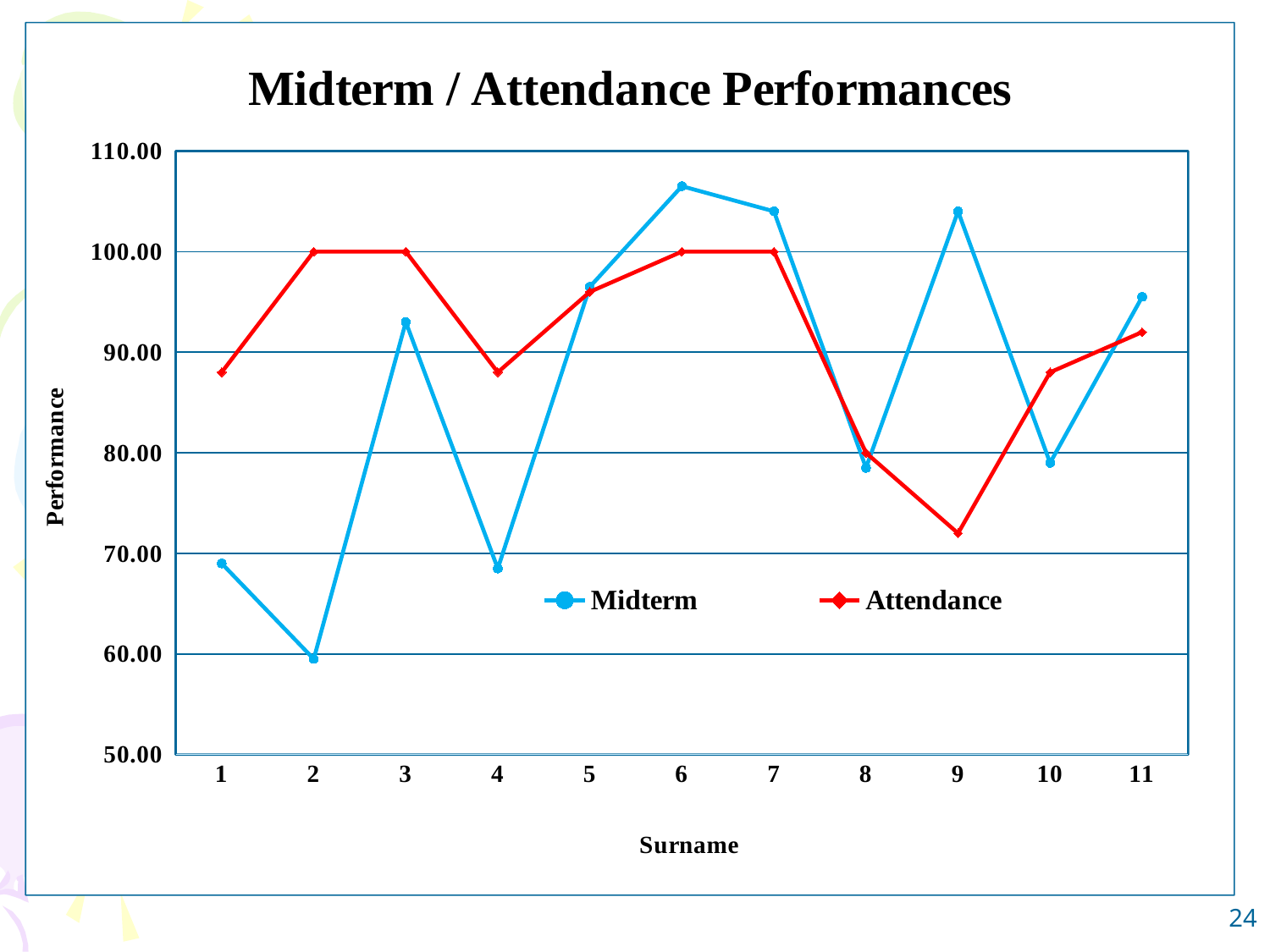
Is the Midterm value for surname 9 greater or less than 100.00? greater How many series does the legend list? 2 What is the Attendance value for surname 2? 100.00 At which surname number is the Midterm value highest? 6 At which surname number is the Midterm value lowest? 2 At which surname number is the Attendance value lowest? 9 For surname 3, which is larger, the Midterm value or the Attendance value? Attendance What is the Attendance value for surname 7? 100.00 What kind of chart is shown on the slide? line chart What is the title of the x axis? Surname Is the Attendance value for surname 9 greater or less than 80.00? less How many points are plotted along the x axis for each series? 11